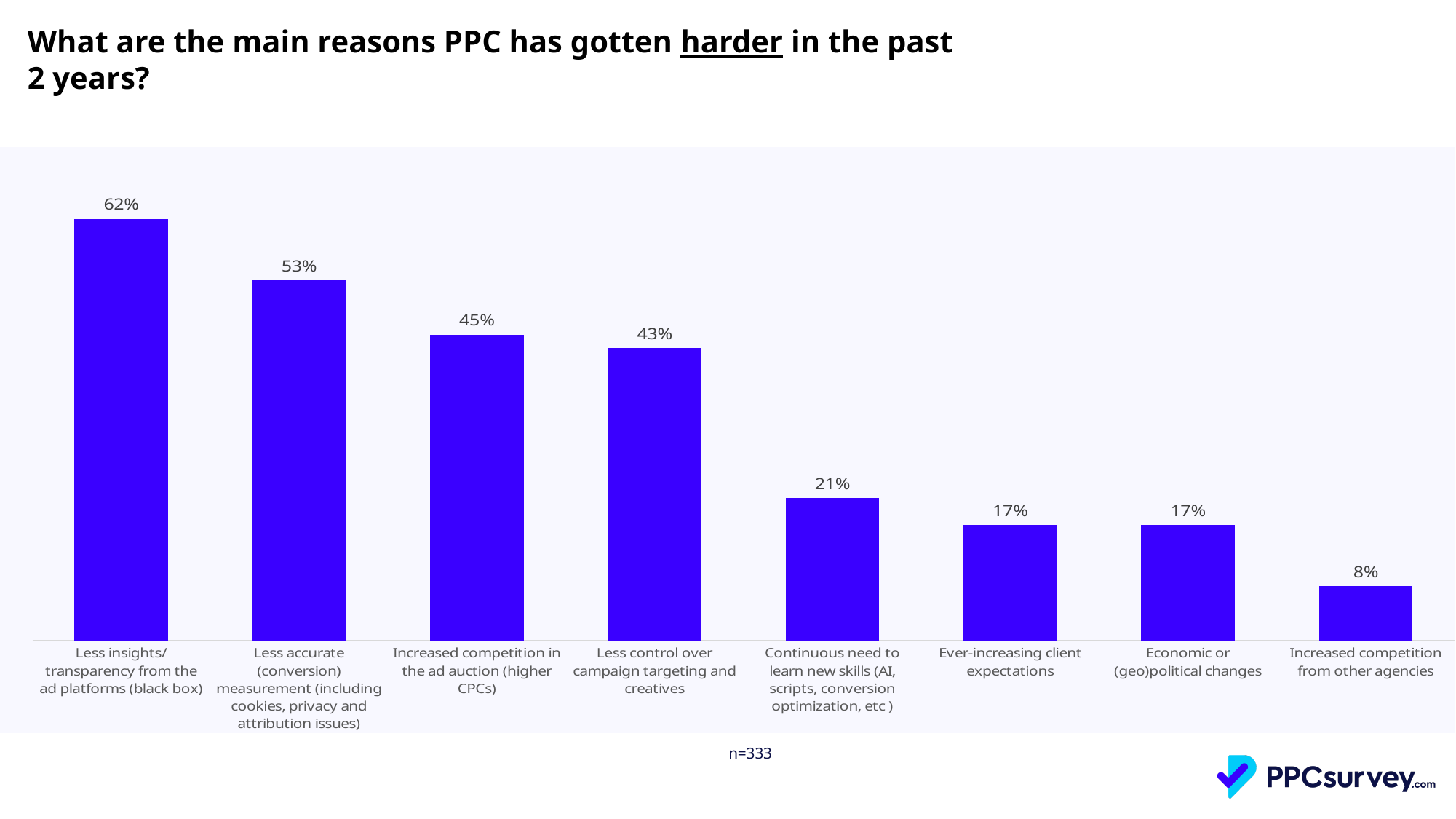
How many reasons (bars) are shown in the chart? 8 What percentage of respondents cited 'Less insights/transparency from the ad platforms (black box)' as a reason PPC has gotten harder? 62% What is the value for 'Increased competition in the ad auction (higher CPCs)'? 45% What is the difference between 'Less accurate (conversion) measurement' and 'Less control over campaign targeting and creatives'? 10 percentage points What kind of chart is shown on the slide? Bar chart Which reason has the highest percentage? Less insights/transparency from the ad platforms (black box) Do the values rise or fall from left to right across the chart? Fall Which is larger: 'Increased competition in the ad auction (higher CPCs)' or 'Less control over campaign targeting and creatives'? Increased competition in the ad auction (higher CPCs) Which reason has the lowest percentage? Increased competition from other agencies What is the sample size (n) noted below the chart? n=333 What percentage is shown for 'Continuous need to learn new skills (AI, scripts, conversion optimization, etc)'? 21% Which two reasons share the same value of 17%? Ever-increasing client expectations; Economic or (geo)political changes